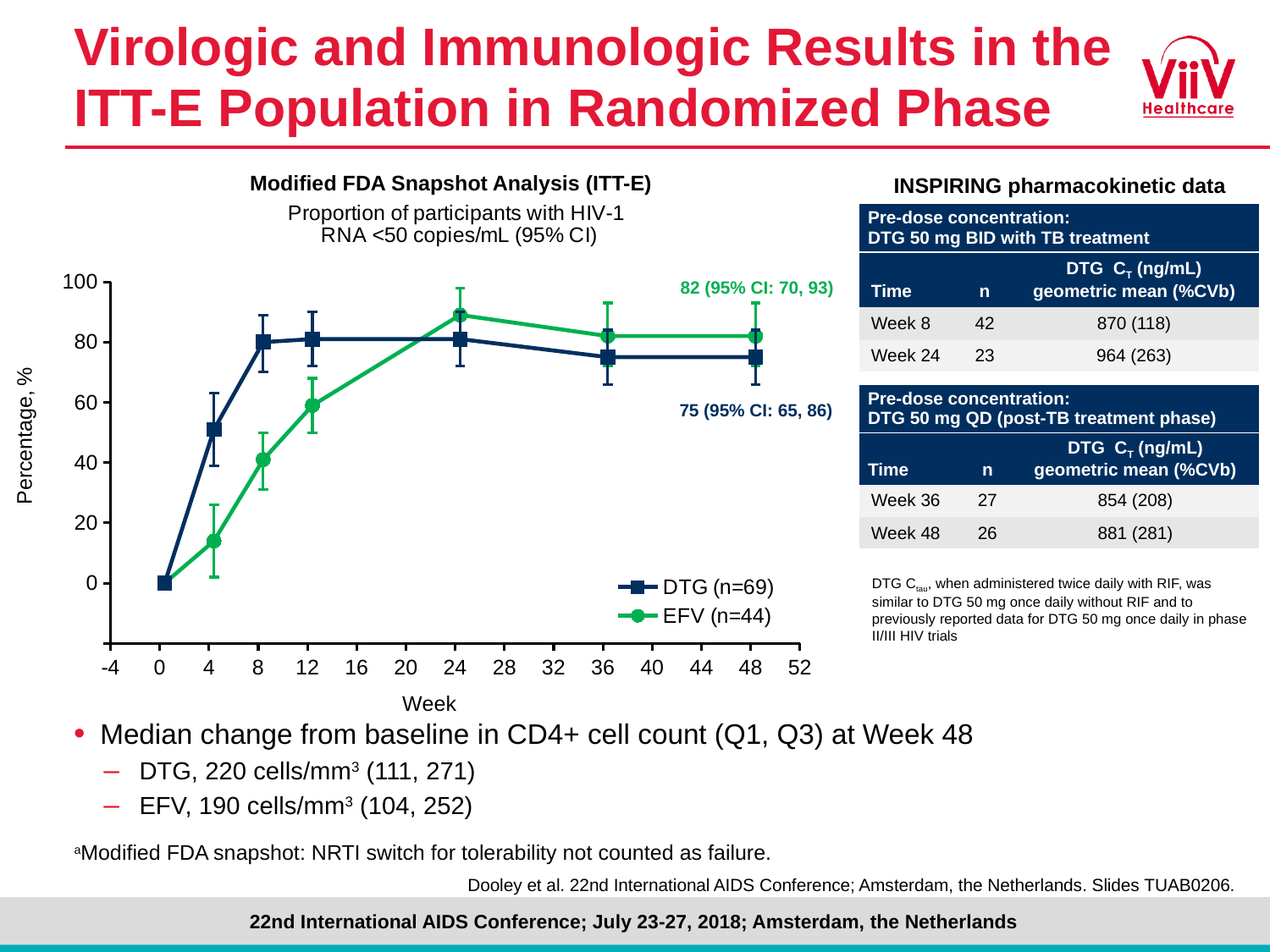
How many series does the legend of the line chart list? 2 In the line chart, which series has the higher value at Week 4, DTG or EFV? DTG In the line chart, what is the difference between the EFV and DTG point estimates at Week 48? 7 In the line chart, is the value for EFV at Week 8 greater or less than 60? less In the line chart, does the EFV series rise or fall between Week 0 and Week 24? Rise In the line chart, which series has the higher value at Week 48, DTG or EFV? EFV In the line chart, what is the labelled value for EFV at Week 48? 82 (95% CI: 70, 93) In the line chart, what is the labelled value for DTG at Week 48? 75 (95% CI: 65, 86) In the line chart, is the value for DTG at Week 4 greater or less than 40? greater In the line chart, is the value for EFV at Week 4 greater or less than 20? less What kind of chart is shown under the title 'Modified FDA Snapshot Analysis (ITT-E)'? Line chart What is the label on the y-axis of the line chart? Percentage, %